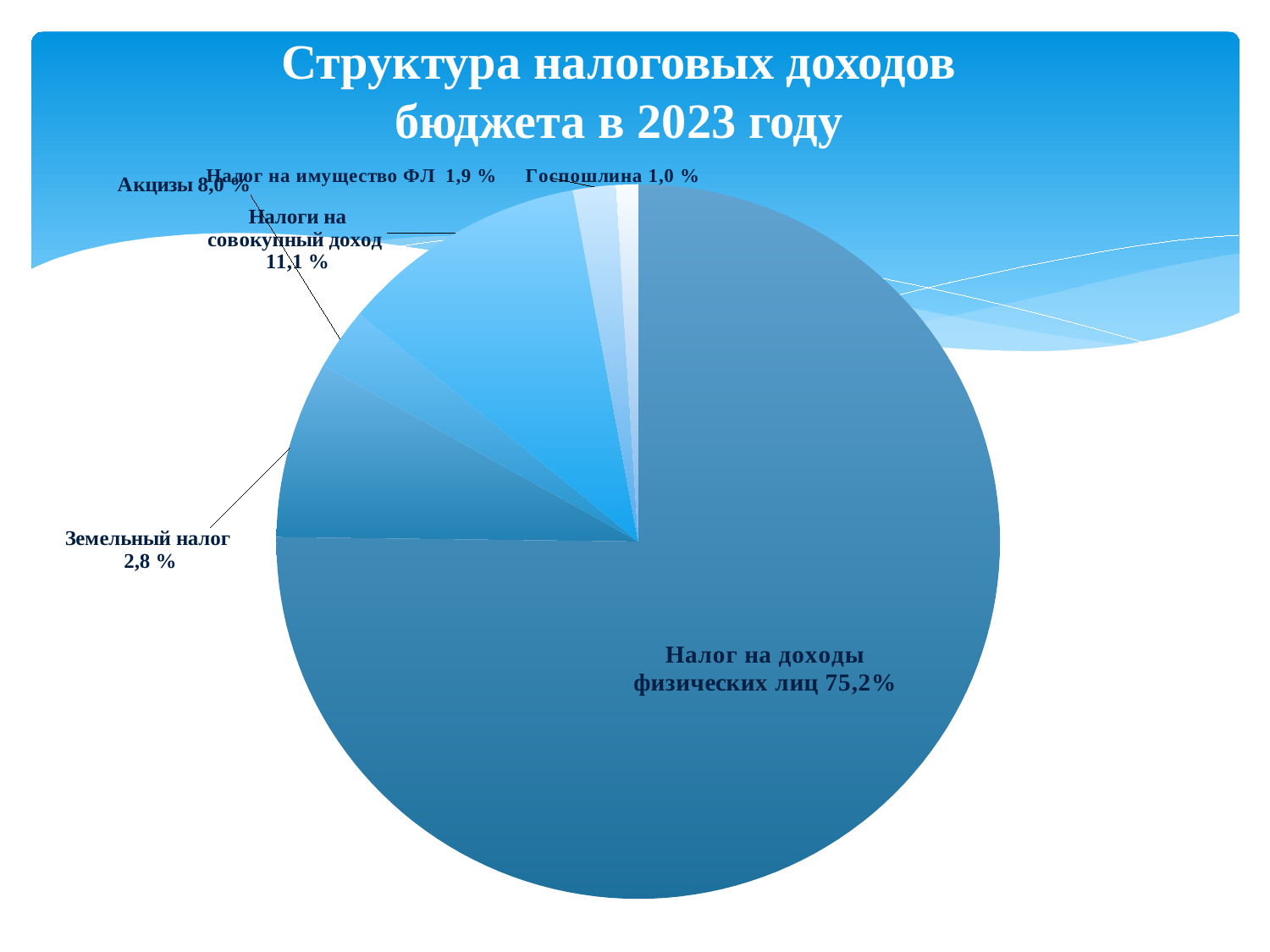
What is the value shown for Акцизы? 8,0 % What is the title of the chart? Структура налоговых доходов бюджета в 2023 году What share of the pie is Налог на доходы физических лиц? 75,2% What kind of chart is shown on the slide? Pie chart How many slices does the pie chart have? 6 Which category has the largest share of the pie? Налог на доходы физических лиц What is the difference between the shares of Налоги на совокупный доход and Акцизы? 3,1 % Which category has the smallest share of the pie? Госпошлина What is the value shown for Земельный налог? 2,8 % What is the value shown for Налоги на совокупный доход? 11,1 % Which is larger, Акцизы or Налог на имущество ФЛ? Акцизы What is the value shown for Госпошлина? 1,0 %